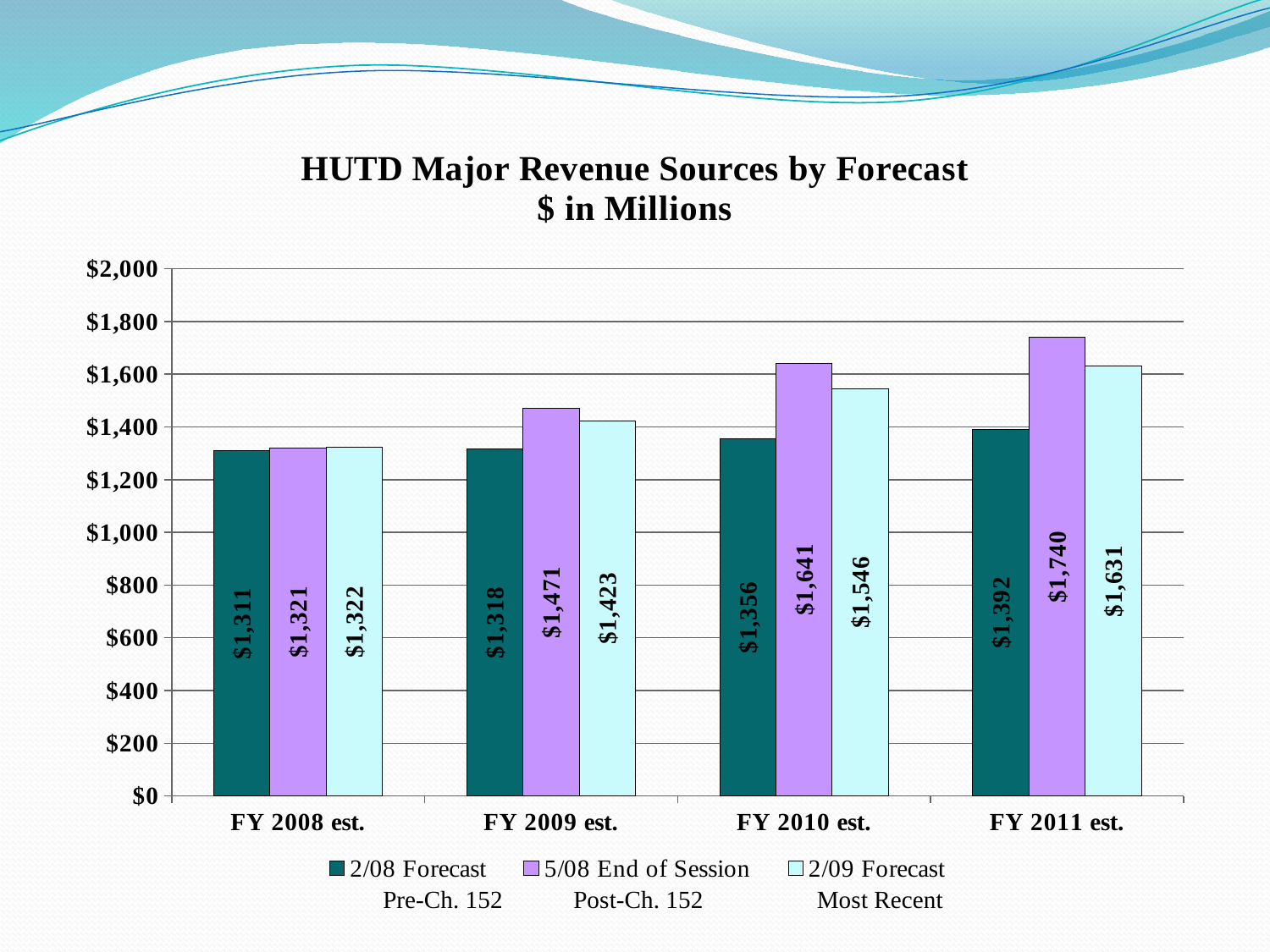
Which fiscal year has the lowest 2/08 Forecast value? FY 2008 est. How many series does the legend list? 3 Is the 2/09 Forecast value for FY 2010 est. greater or less than $1,400? greater What kind of chart is shown on the slide? bar chart What is the 5/08 End of Session value for FY 2010 est.? $1,641 For FY 2010 est., which is larger: the 5/08 End of Session value or the 2/09 Forecast value? 5/08 End of Session What is the difference between the 5/08 End of Session and 2/09 Forecast values for FY 2011 est.? $109 Do the 2/08 Forecast values rise or fall from FY 2008 est. to FY 2011 est.? rise How many fiscal year categories are shown on the x axis? 4 What is the 2/09 Forecast value for FY 2009 est.? $1,423 What is the 2/08 Forecast value for FY 2011 est.? $1,392 Which fiscal year has the highest 5/08 End of Session value? FY 2011 est.